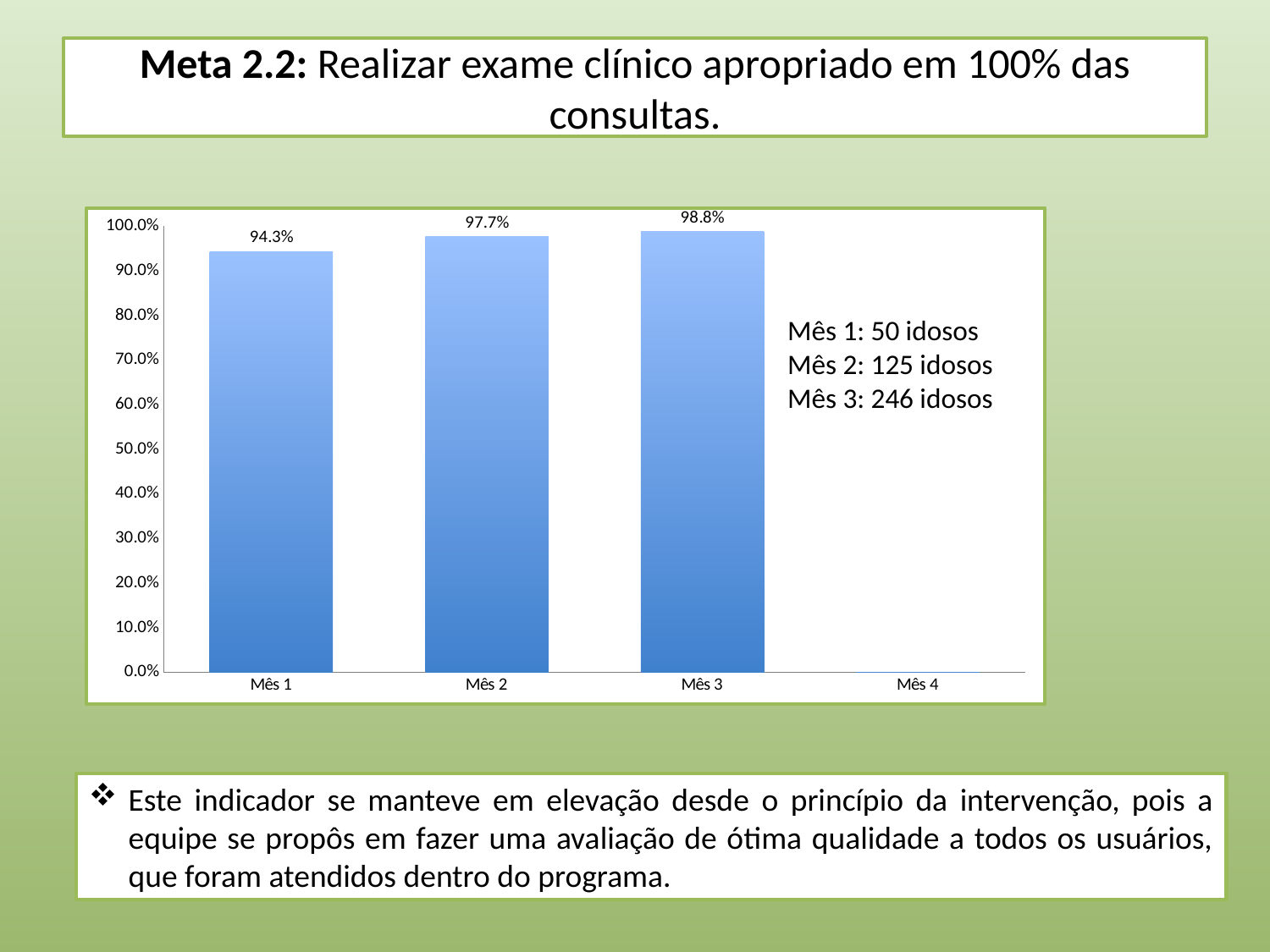
Which is larger, the value for Mês 2 or the value for Mês 1? Mês 2 What is the value shown for Mês 1? 94.3% How many month categories are labelled on the x axis of the chart? 4 Which month has the highest bar in the chart? Mês 3 What kind of chart is shown on the slide? Bar chart What is the value shown for Mês 2? 97.7% Among the months that have a bar plotted, which has the lowest value? Mês 1 Is the value for Mês 1 greater or less than 90.0%? greater Do the values rise or fall from Mês 1 to Mês 3? Rise What is the difference between the values for Mês 3 and Mês 1? 4.5 percentage points What is the difference between the values for Mês 2 and Mês 1? 3.4 percentage points What is the value shown for Mês 3? 98.8%